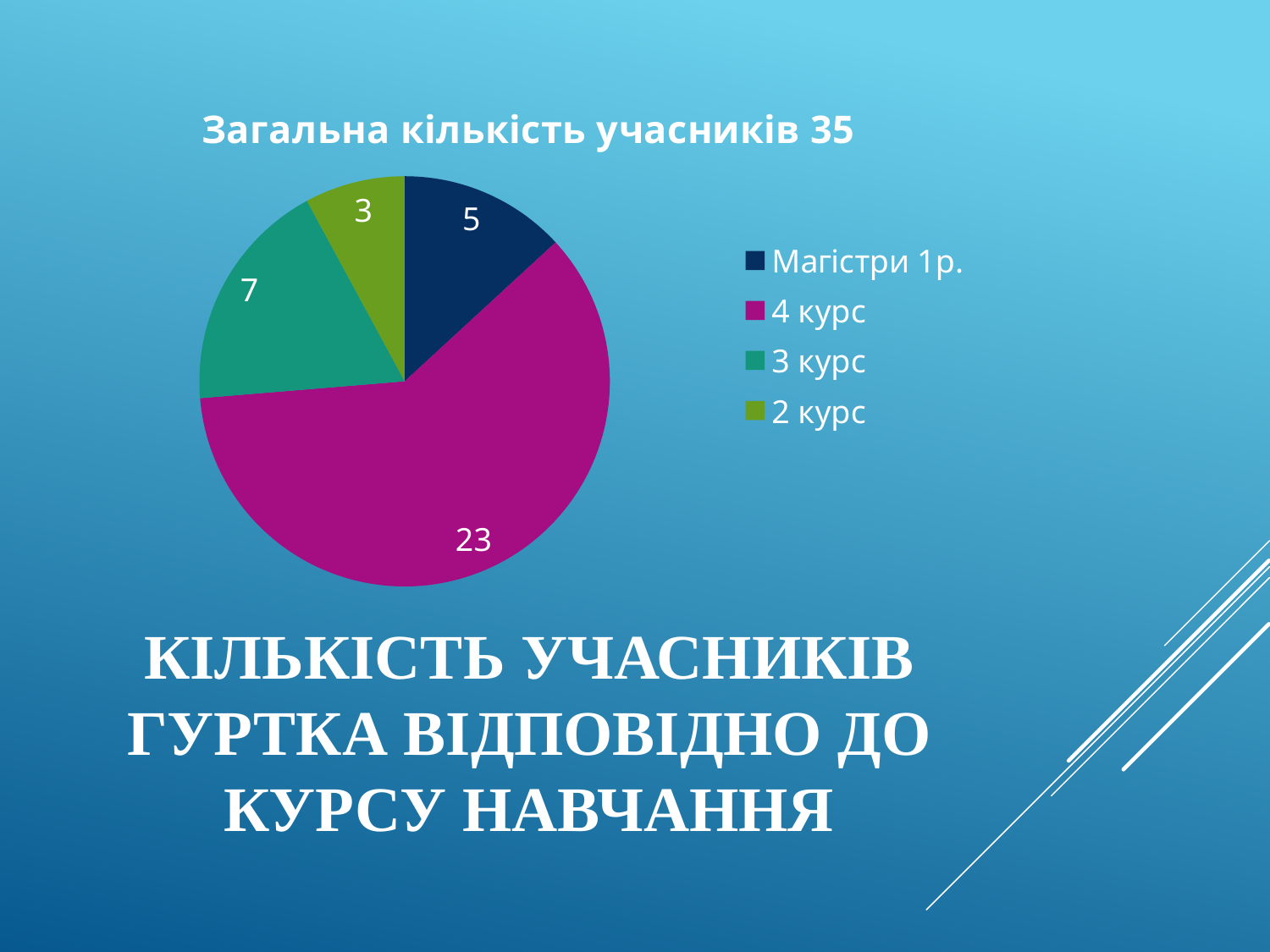
What is the value for 2 курс? 3 What kind of chart is shown on the slide? pie chart What is the value for 3 курс? 7 What is the title of the chart? Загальна кількість учасників 35 Which category has the largest slice? 4 курс Which is larger, the value for 3 курс or the value for Магістри 1р.? 3 курс How many entries does the legend list? 4 What is the difference between the values for 4 курс and 3 курс? 16 Which category has the smallest slice? 2 курс What is the value for 4 курс? 23 How many slices does the pie chart have? 4 What is the value for Магістри 1р.? 5